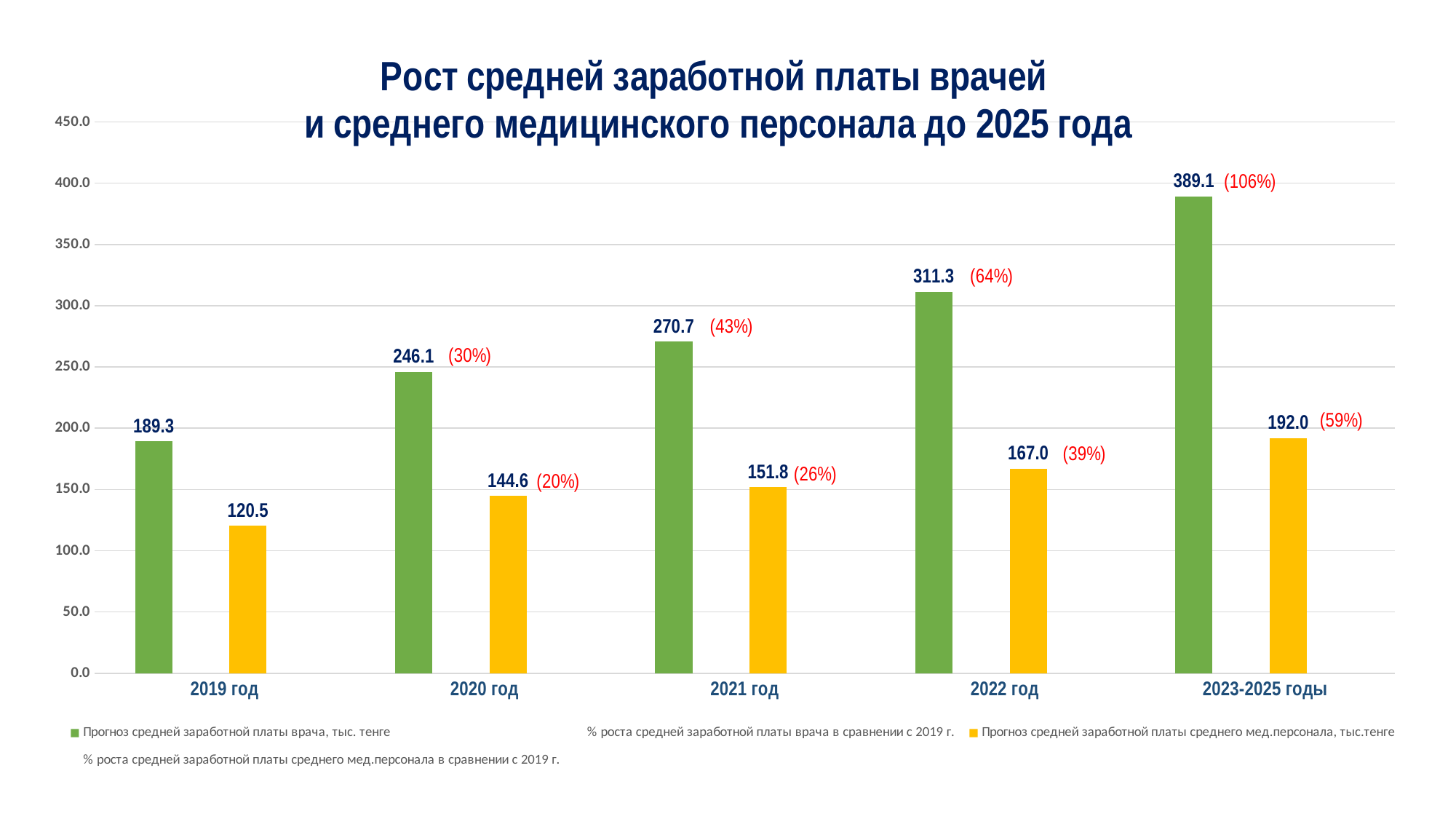
What is the forecast average salary of mid-level medical staff (среднего мед.персонала) for 2022 год? 167.0 What type of chart is shown on the slide? Bar chart How many time periods are shown on the x axis? 5 What percentage growth compared to 2019 is shown for the mid-level medical staff salary in 2020 год? 20% How many entries does the legend list? 4 Do the forecast doctor's salary values rise or fall from 2019 год to 2023-2025 годы? Rise What is the difference between the forecast doctor's salary and the mid-level medical staff salary in 2019 год? 68.8 Which is larger in 2022 год: the forecast doctor's salary or the forecast mid-level medical staff salary? Forecast doctor's salary (311.3) What percentage growth compared to 2019 is shown for the doctor's salary in 2023-2025 годы? 106% In which period is the forecast doctor's salary the highest? 2023-2025 годы In which year is the forecast mid-level medical staff salary the lowest? 2019 год What is the forecast average salary of a doctor (Прогноз средней заработной платы врача) for 2021 год? 270.7